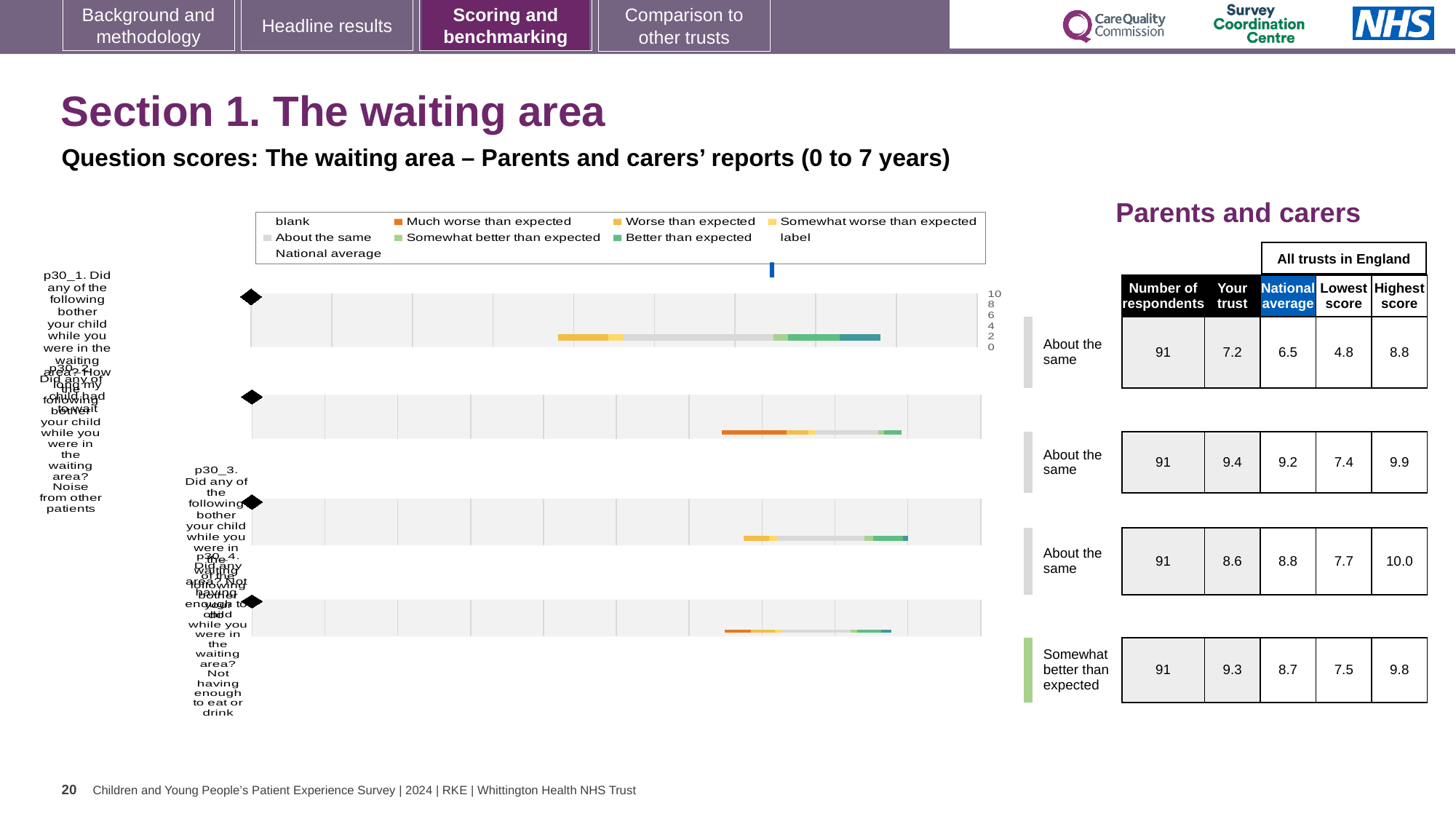
In the table beside the chart, which question row has the highest 'Your trust' score? p30_2 (9.4) In the chart legend, what colour represents 'Much worse than expected'? orange What kind of chart is shown on the slide? bar chart In the table beside the chart, what is the 'National average' for the second question row (p30_2)? 9.2 How many question rows (bars) does the chart show? 4 In the table beside the chart, what is the 'Your trust' score for the first question row (p30_1)? 7.2 How many respondents are listed for each question row in the table beside the chart? 91 For the first question row (p30_1), what is the difference between the 'Your trust' score and the 'National average'? 0.7 What benchmark label is given for the fourth question row (p30_4)? Somewhat better than expected What is the highest value shown on the chart's numeric axis? 10 For the third question row (p30_3), which is larger: the 'Your trust' score or the 'National average'? National average In the table beside the chart, which question row has the lowest 'Your trust' score? p30_1 (7.2)